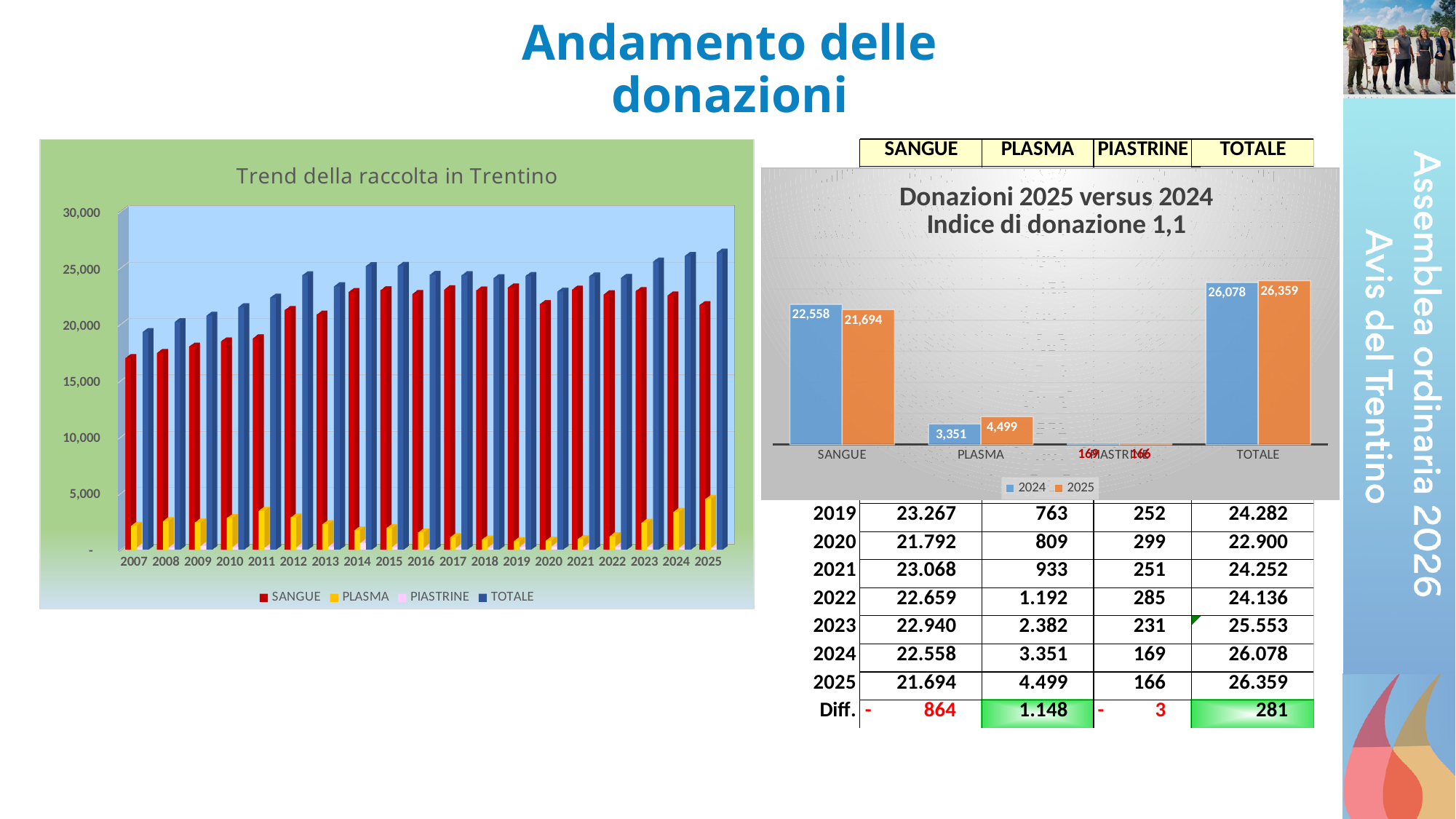
What kind of chart is the chart titled 'Trend della raccolta in Trentino'? bar chart In the chart titled 'Donazioni 2025 versus 2024', what is the 2025 value for TOTALE? 26,359 In the chart titled 'Donazioni 2025 versus 2024', how many series does the legend list? 2 In the chart titled 'Donazioni 2025 versus 2024', what is the 2024 value for SANGUE? 22,558 In the chart titled 'Trend della raccolta in Trentino', how many series does the legend list? 4 In the chart titled 'Donazioni 2025 versus 2024', which category has the lowest values? PIASTRINE In the chart titled 'Trend della raccolta in Trentino', is the SANGUE value for 2007 greater or less than 20,000? less In the chart titled 'Trend della raccolta in Trentino', is the TOTALE value for 2025 greater or less than 25,000? greater In the chart titled 'Trend della raccolta in Trentino', how many years are shown on the x axis? 19 In the chart titled 'Donazioni 2025 versus 2024', which is larger for SANGUE, the 2024 value or the 2025 value? 2024 In the chart titled 'Donazioni 2025 versus 2024', what is the 2025 value for PLASMA? 4,499 In the chart titled 'Donazioni 2025 versus 2024', what is the difference between the 2025 and 2024 values for PLASMA? 1,148